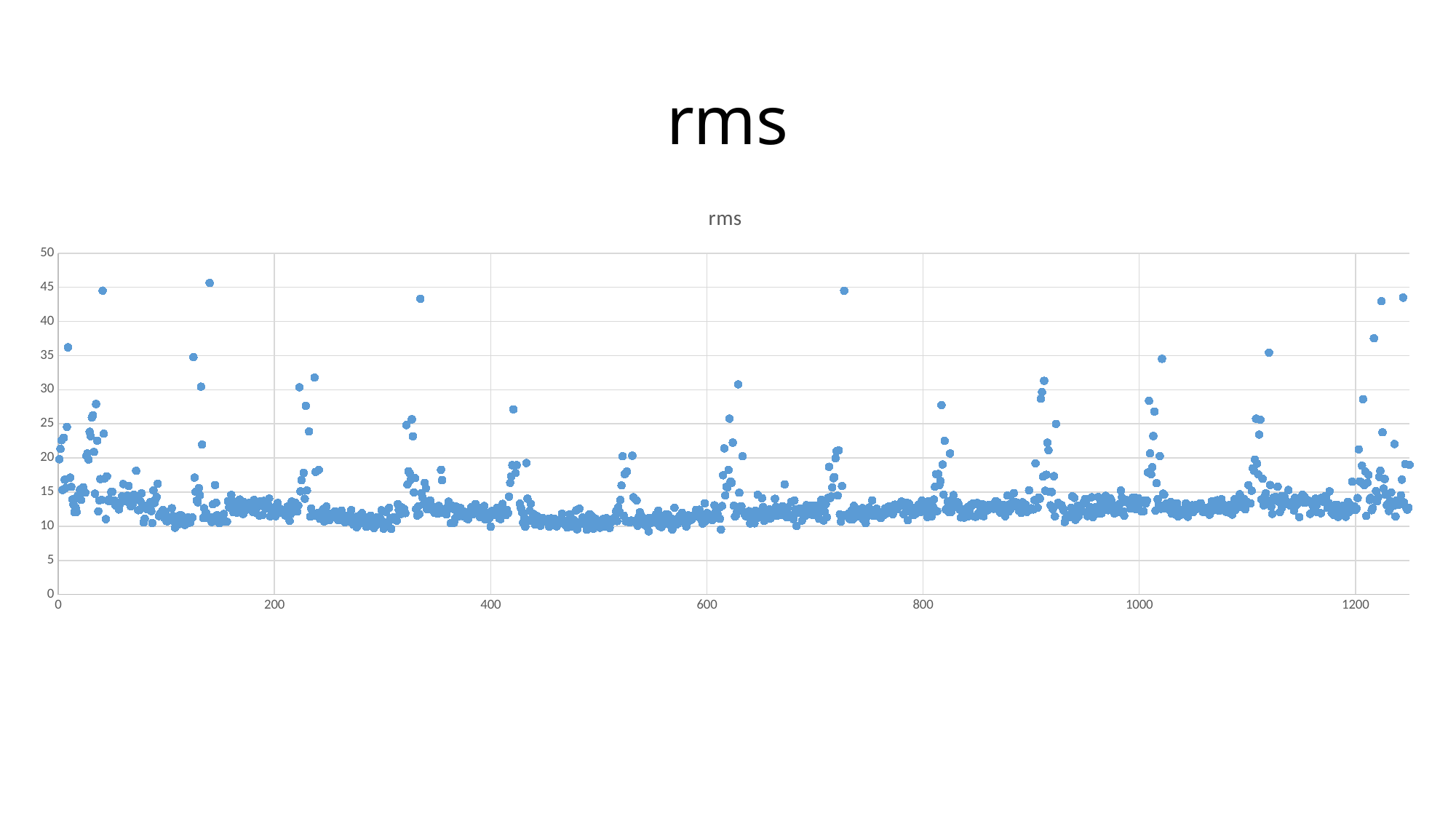
How many data series are plotted on the chart? 1 What is the interval between consecutive tick labels on the horizontal axis? 200 What is the title of the chart? rms Is the lowest plotted point greater or less than 5? greater What kind of chart is shown on the slide? scatter chart What is the interval between consecutive tick labels on the vertical axis? 5 What is the highest value labelled on the vertical axis? 50 What is the largest tick label shown on the horizontal axis? 1200 Is the highest plotted point greater or less than 40? greater